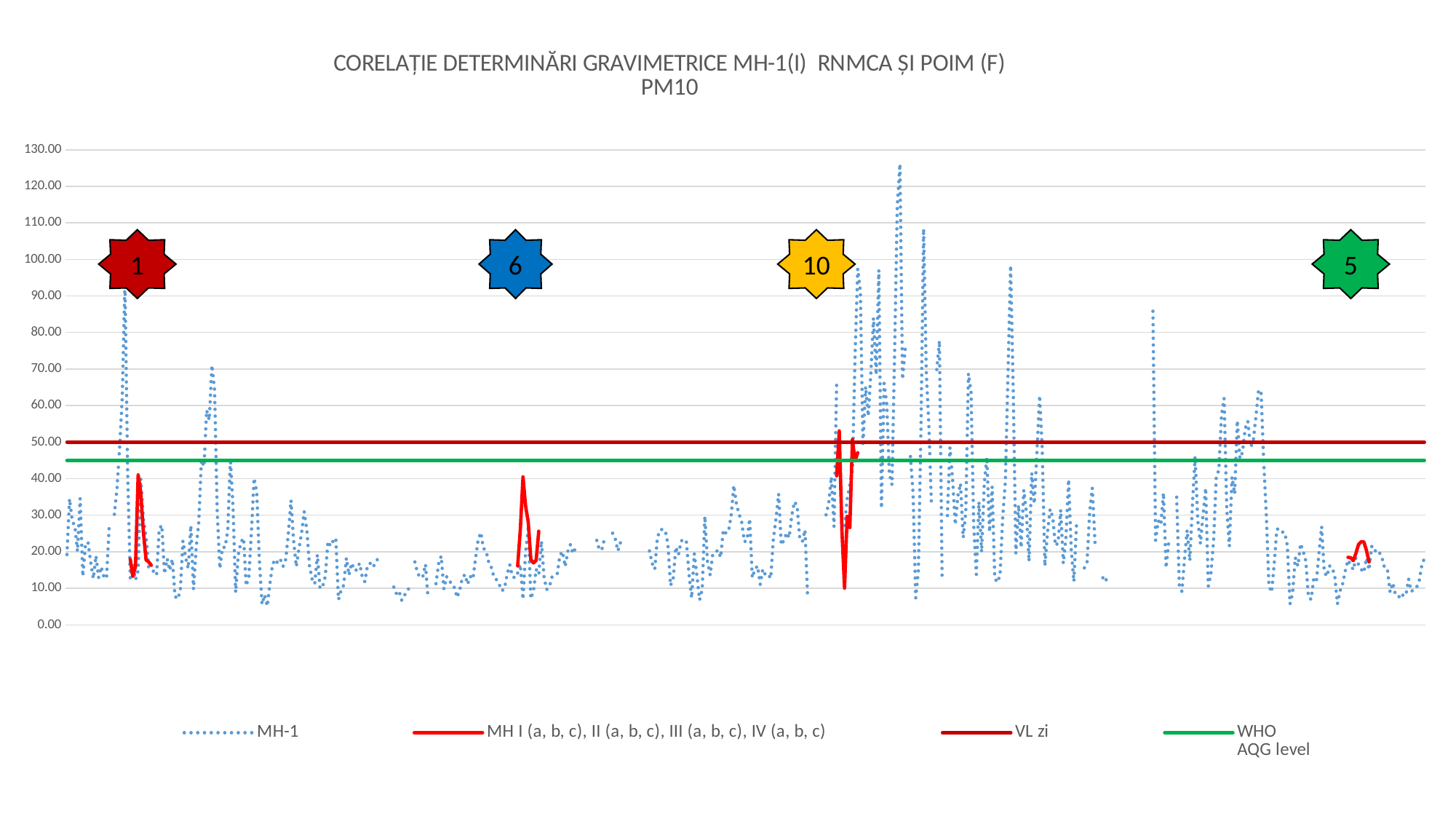
Which is higher, the VL zi line or the WHO AQG level line? VL zi Is the peak of the red MH I (a, b, c), II (a, b, c), III (a, b, c), IV (a, b, c) series near the blue star labelled 6 greater or less than 50.00? less How many series does the legend list? 4 Which series is drawn as a dotted blue line? MH-1 Is the highest peak of the MH-1 series greater or less than 120.00? greater What kind of chart is shown on the slide? line chart Is the WHO AQG level line greater or less than 40.00? greater What is the title of the chart? CORELAȚIE DETERMINĂRI GRAVIMETRICE MH-1(I) RNMCA ȘI POIM (F) PM10 At what value is the VL zi line drawn? 50.00